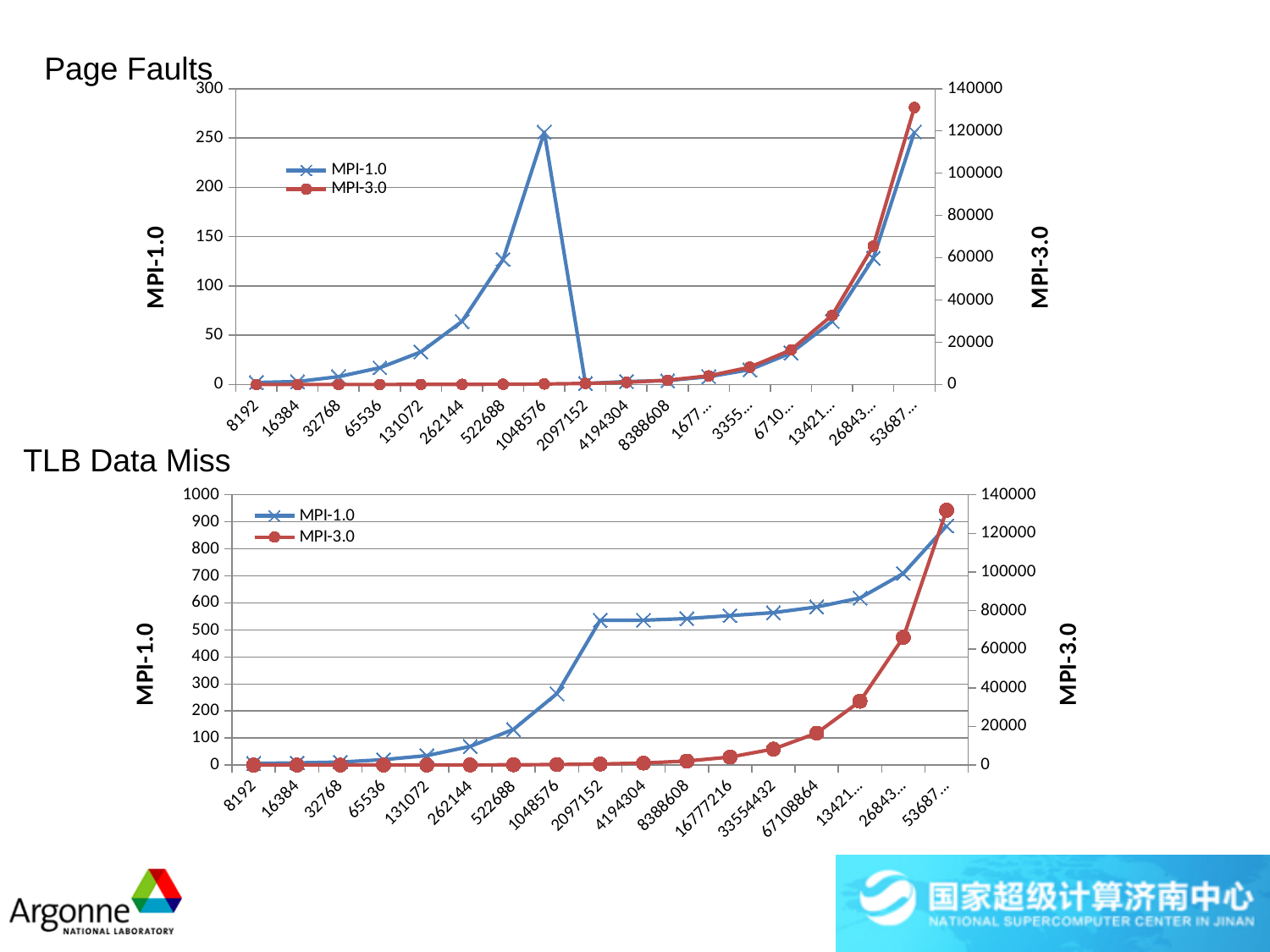
In the TLB Data Miss chart, which series is larger at 1048576 on its own axis scale: MPI-1.0 (left axis, ~270) or MPI-3.0 (right axis, near 0)? MPI-1.0 What kind of chart is the Page Faults chart? line chart In the TLB Data Miss chart, how many categories are shown on the x axis? 17 In the TLB Data Miss chart, is the MPI-1.0 value at 2097152 greater or less than 400? greater How many series does the legend of the TLB Data Miss chart list? 2 In the TLB Data Miss chart, is the MPI-3.0 value at 26843... greater or less than 40000 on the right axis? greater In the Page Faults chart, is the MPI-1.0 value at 1048576 greater or less than 200? greater In the TLB Data Miss chart, does the MPI-3.0 series rise or fall along the x axis? rise What are the two series named in the legend of the Page Faults chart? MPI-1.0 and MPI-3.0 In the Page Faults chart, at which category does the MPI-3.0 series reach its highest value? 53687... In the TLB Data Miss chart, at which category does the MPI-1.0 series reach its highest value? 53687...